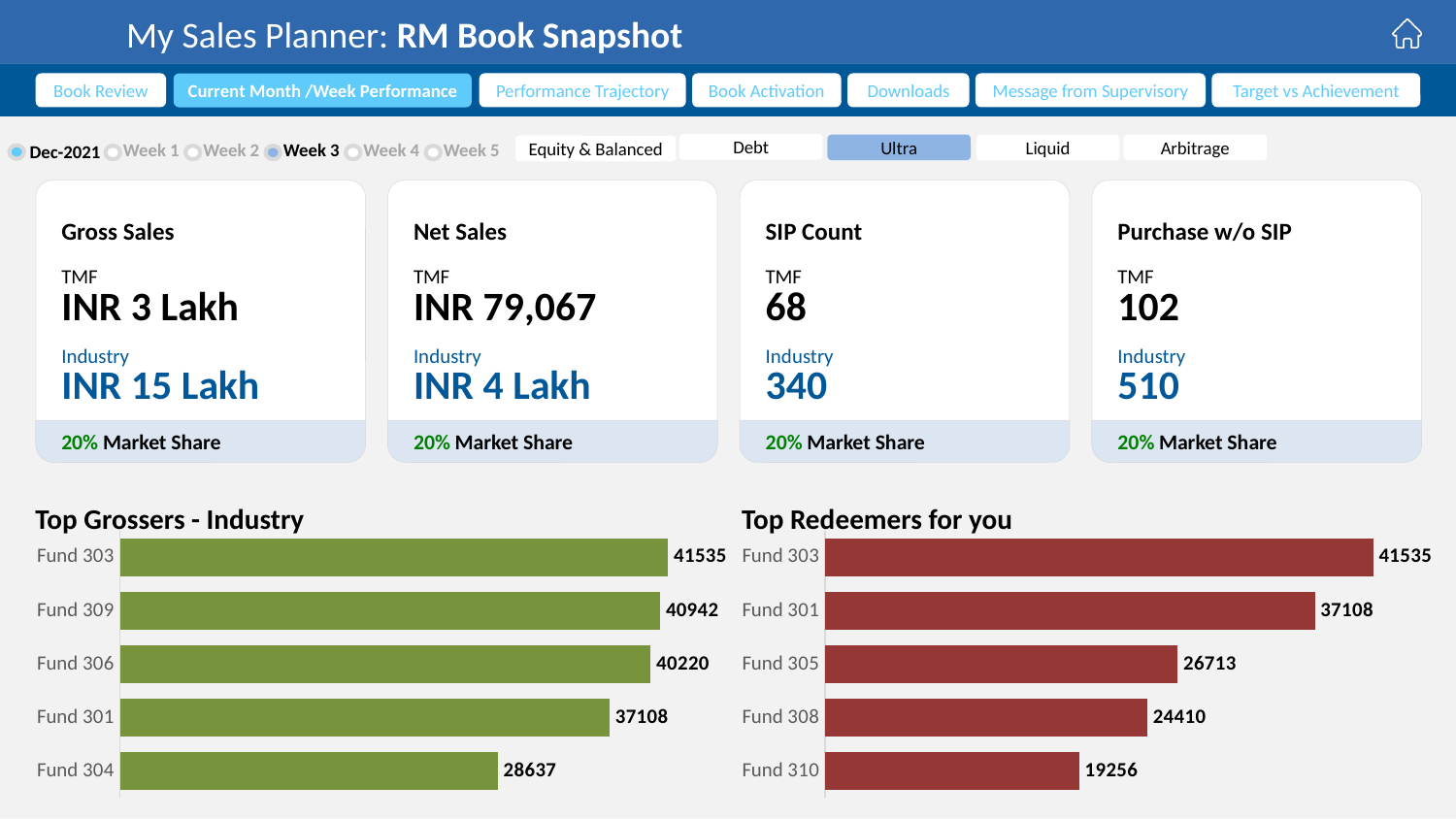
What colour are the bars in the 'Top Redeemers for you' chart? Red In the 'Top Redeemers for you' chart, do the values rise or fall going down the list of funds? Fall In the 'Top Grossers - Industry' chart, how many funds are shown? 5 In the 'Top Redeemers for you' chart, what is the value for Fund 305? 26713 In the 'Top Grossers - Industry' chart, what is the value for Fund 306? 40220 In the 'Top Redeemers for you' chart, what is the difference between Fund 301 and Fund 305? 10395 In the 'Top Redeemers for you' chart, which is larger: Fund 308 or Fund 310? Fund 308 In the 'Top Grossers - Industry' chart, which fund has the lowest value? Fund 304 In the 'Top Grossers - Industry' chart, what is the value for Fund 309? 40942 What kind of chart is 'Top Redeemers for you'? Bar chart In the 'Top Grossers - Industry' chart, what is the difference between Fund 303 and Fund 304? 12898 In the 'Top Redeemers for you' chart, which fund has the highest value? Fund 303